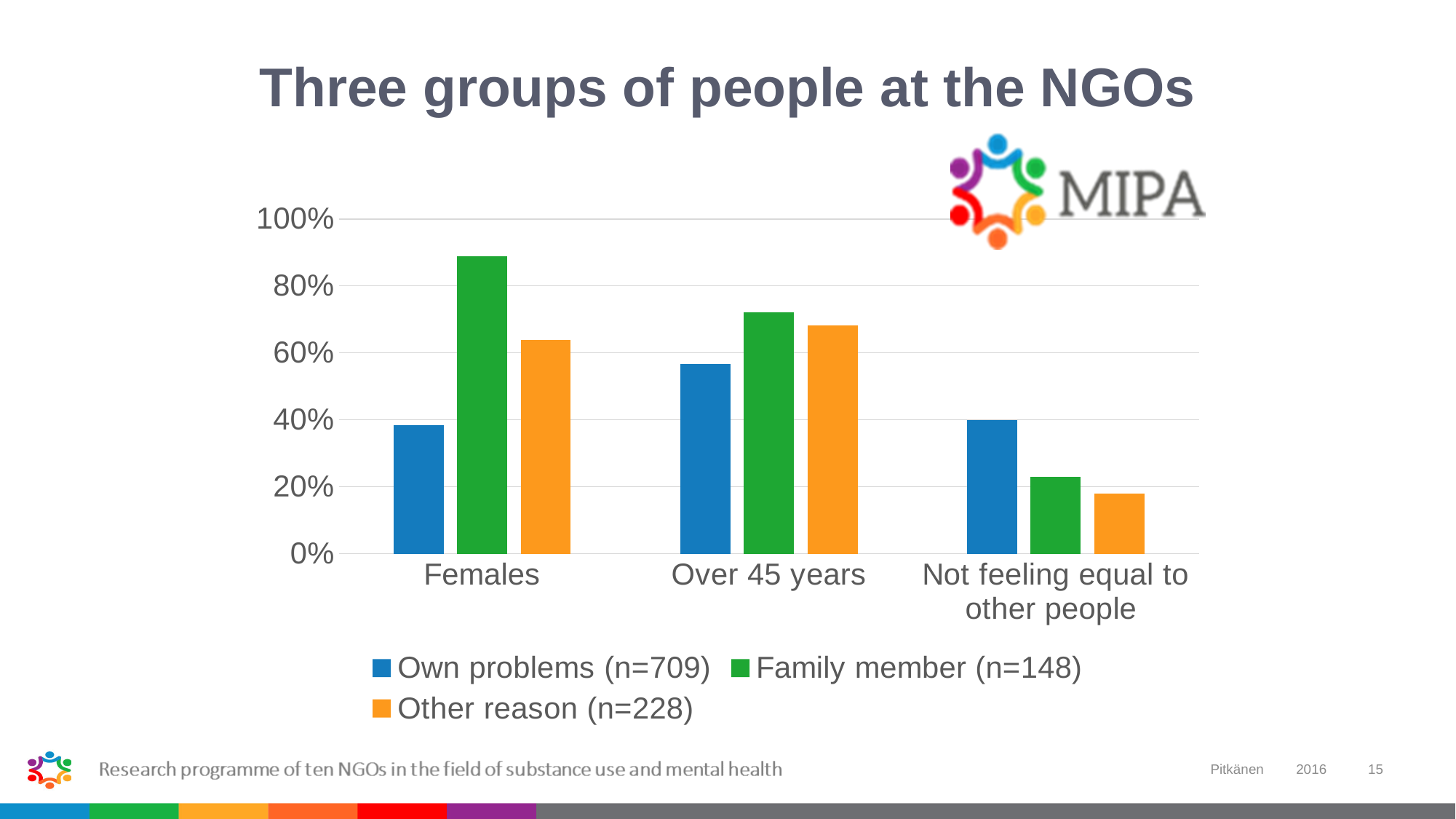
Which series has the lowest value for Females? Own problems (n=709) How many categories are shown on the x axis? 3 Is the value for Family member (n=148) in the Females category greater or less than 80%? greater What is the sample size (n) given in the legend for the Own problems series? 709 Which series has the lowest value for Not feeling equal to other people? Other reason (n=228) For Own problems (n=709), which category has the larger value: Females or Over 45 years? Over 45 years Which series has the highest value for Females? Family member (n=148) Which series has the highest value for Not feeling equal to other people? Own problems (n=709) How many series does the legend list? 3 Is the value for Other reason (n=228) in the Not feeling equal to other people category greater or less than 40%? less Is the value for Own problems (n=709) in the Over 45 years category greater or less than 40%? greater What kind of chart is shown on the slide? bar chart